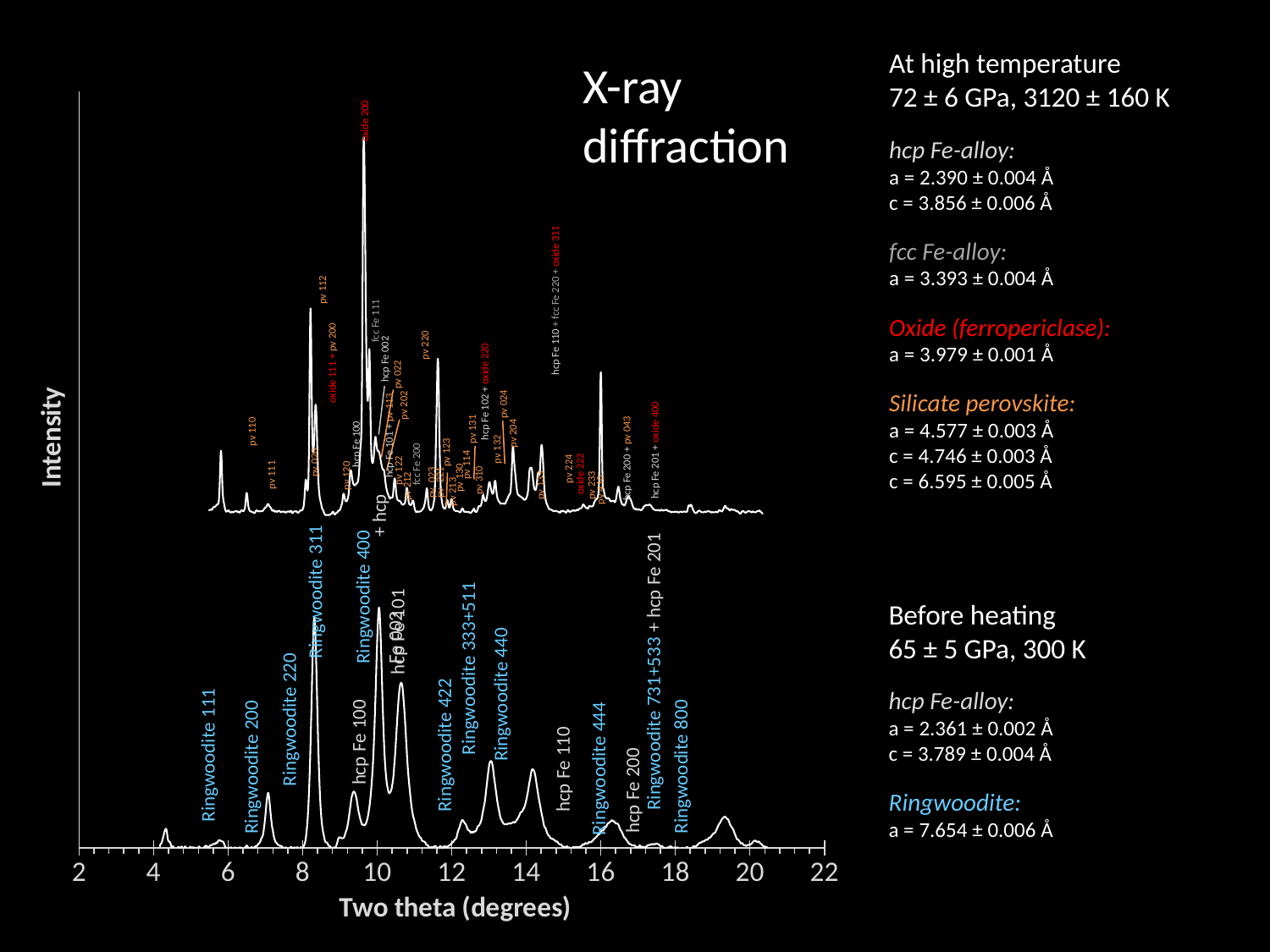
In the lower (before heating) pattern, is the Ringwoodite 311 peak located at a two theta greater or less than 10? less What is the highest tick value shown on the x axis? 22 In the lower (before heating) pattern, which peak is taller: Ringwoodite 111 or Ringwoodite 311? Ringwoodite 311 What is the title of the chart? X-ray diffraction In the upper (high temperature) pattern, which labelled peak is the tallest? oxide 200 In the lower (before heating) pattern, is the Ringwoodite 440 peak located at a two theta greater or less than 12? greater How many diffraction patterns (traces) are plotted on the chart? 2 In the upper (high temperature) pattern, which peak is taller: oxide 200 or pv 112? oxide 200 What is the label of the x axis of the chart? Two theta (degrees) In the upper (high temperature) pattern, is the oxide 200 peak located at a two theta greater or less than 8? greater What is the lowest tick value shown on the x axis? 2 What kind of chart is shown on the slide? line chart